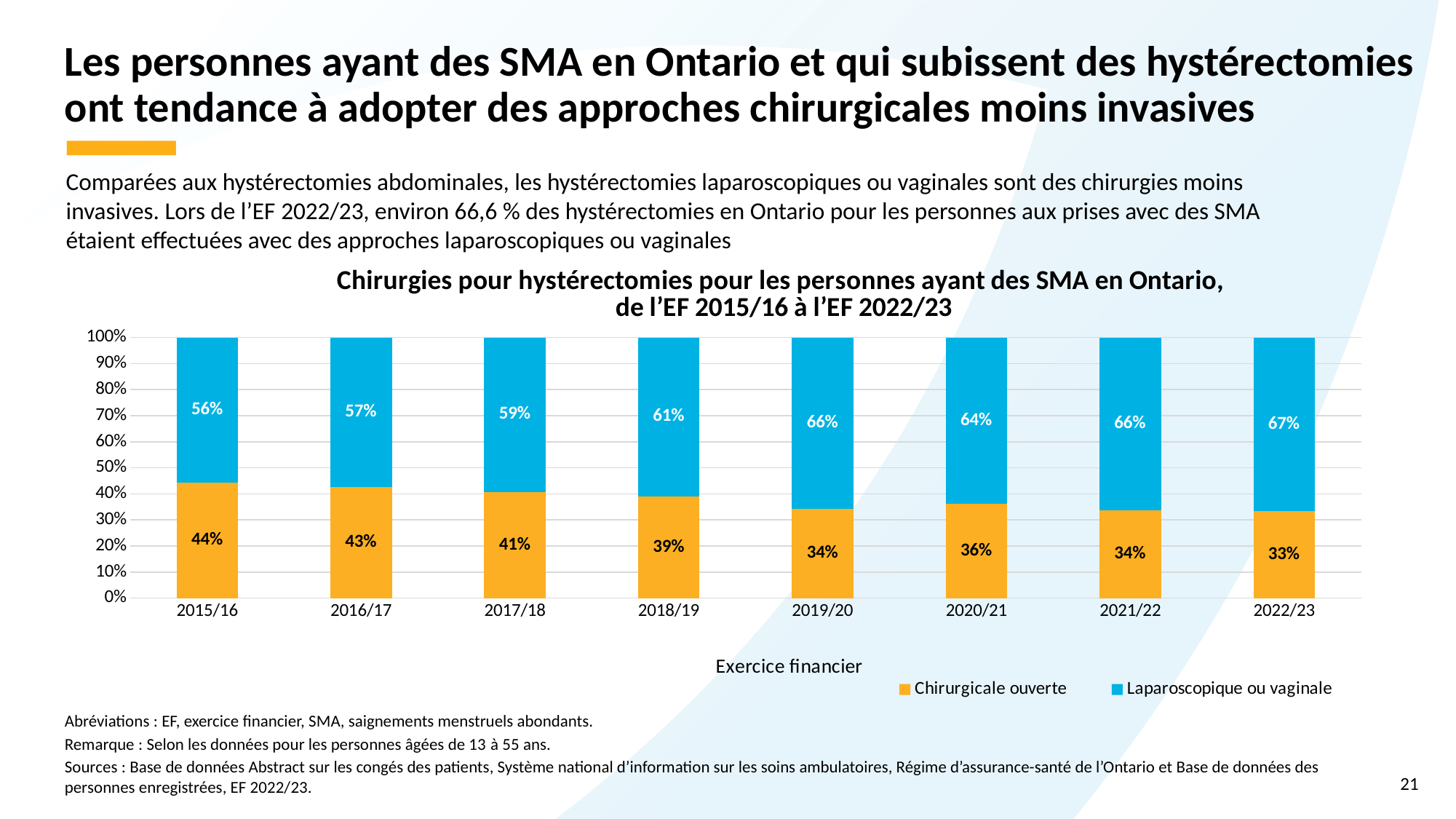
What percentage of hysterectomies in 2015/16 were 'Chirurgicale ouverte'? 44% How many fiscal years are shown on the x axis? 8 What kind of chart is shown on the slide? Stacked bar chart Does the share of 'Chirurgicale ouverte' hysterectomies generally rise or fall from 2015/16 to 2022/23? Fall What is the label of the x axis? Exercice financier What percentage of hysterectomies in 2022/23 were 'Laparoscopique ou vaginale'? 67% Which fiscal year has the highest share of 'Laparoscopique ou vaginale' hysterectomies? 2022/23 Which fiscal year has the lowest share of 'Chirurgicale ouverte' hysterectomies? 2022/23 What is the difference between the 'Chirurgicale ouverte' share in 2015/16 and in 2022/23? 11% How many series does the legend list? 2 Which is larger in 2018/19: the 'Chirurgicale ouverte' share or the 'Laparoscopique ou vaginale' share? Laparoscopique ou vaginale What is the value for 'Chirurgicale ouverte' in 2019/20? 34%